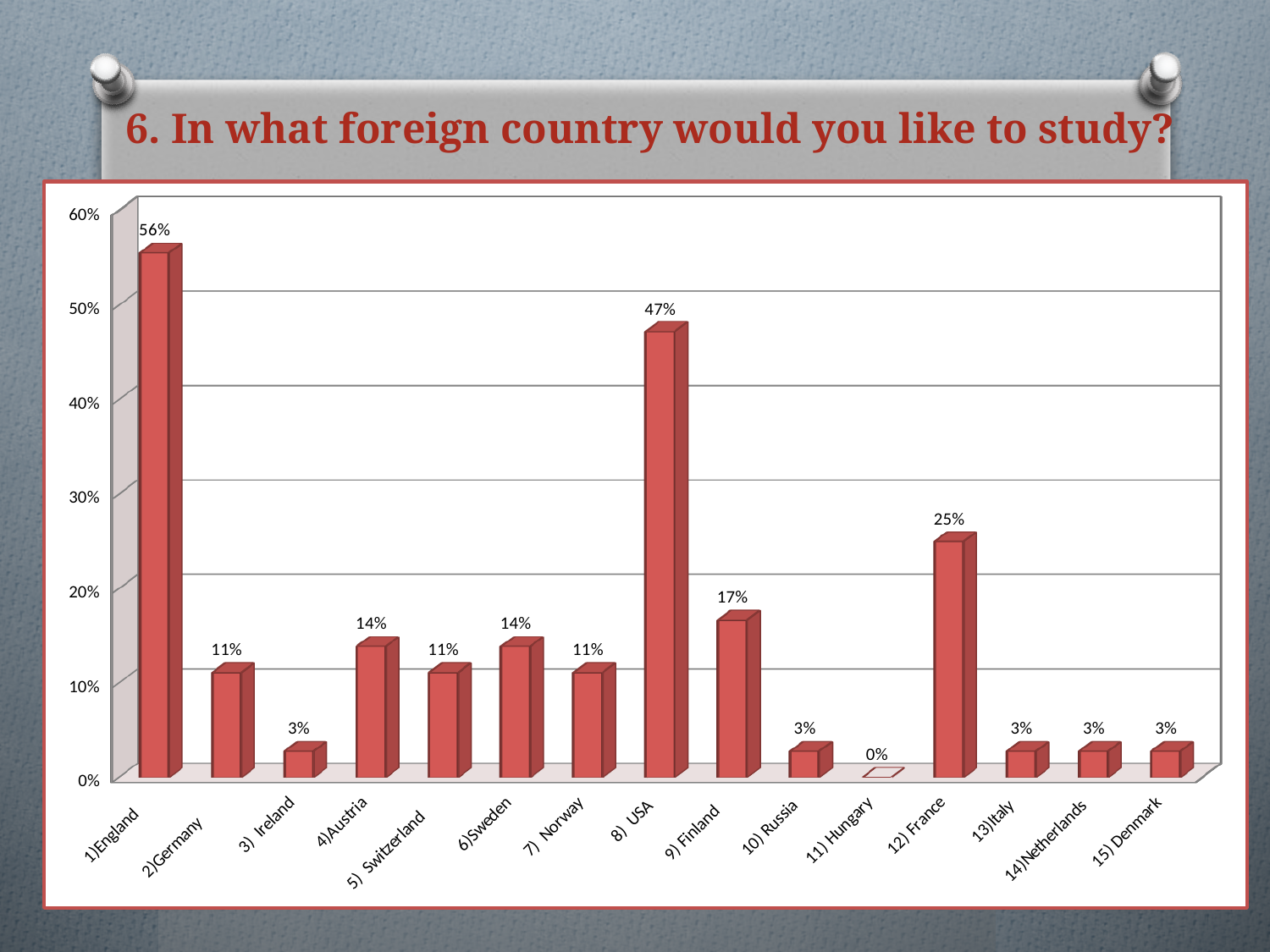
How many countries are shown on the x axis? 15 Is the value for France greater or less than 20%? greater Which country has the lowest value? Hungary What is the value for Finland? 17% Which country has the highest value? England What is the value for France? 25% What kind of chart is shown on the slide? bar chart What is the title of the slide? 6. In what foreign country would you like to study? What is the value for England? 56% What is the value for USA? 47% Which is larger, the value for Austria or the value for Germany? Austria What is the difference between the values for England and USA? 9%